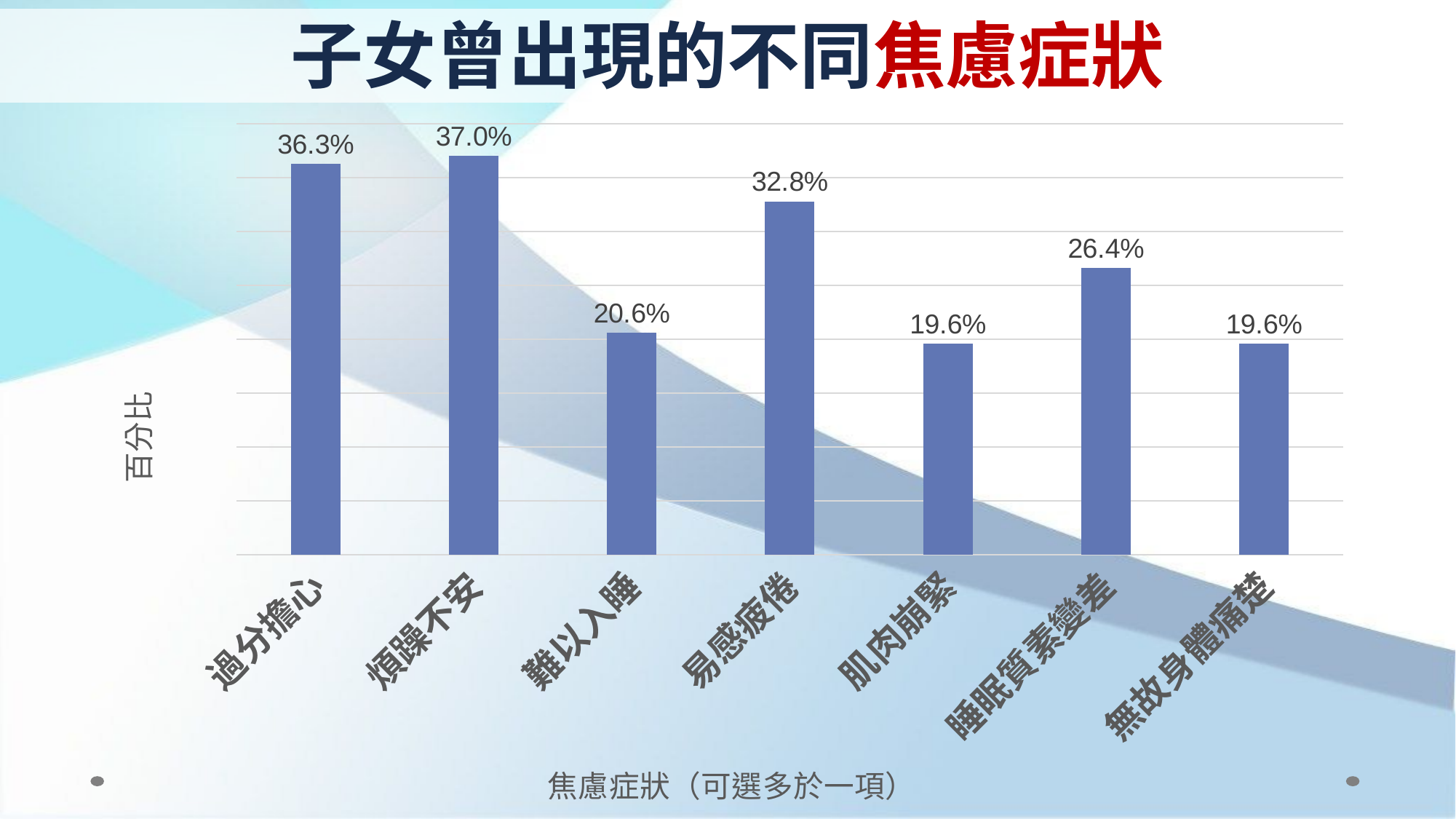
What is the difference between the values for 煩躁不安 and 過分擔心? 0.7% What is the value for 過分擔心? 36.3% Which is larger, the value for 難以入睡 or the value for 肌肉崩緊? 難以入睡 What is the difference between the values for 易感疲倦 and 睡眠質素變差? 6.4% What is the value for 無故身體痛楚? 19.6% What is the value for 難以入睡? 20.6% What is the value for 煩躁不安? 37.0% How many symptom categories are shown in the chart? 7 Which symptom has the highest value? 煩躁不安 What kind of chart is shown on the slide? Bar chart What is the value for 易感疲倦? 32.8% What is the value for 睡眠質素變差? 26.4%